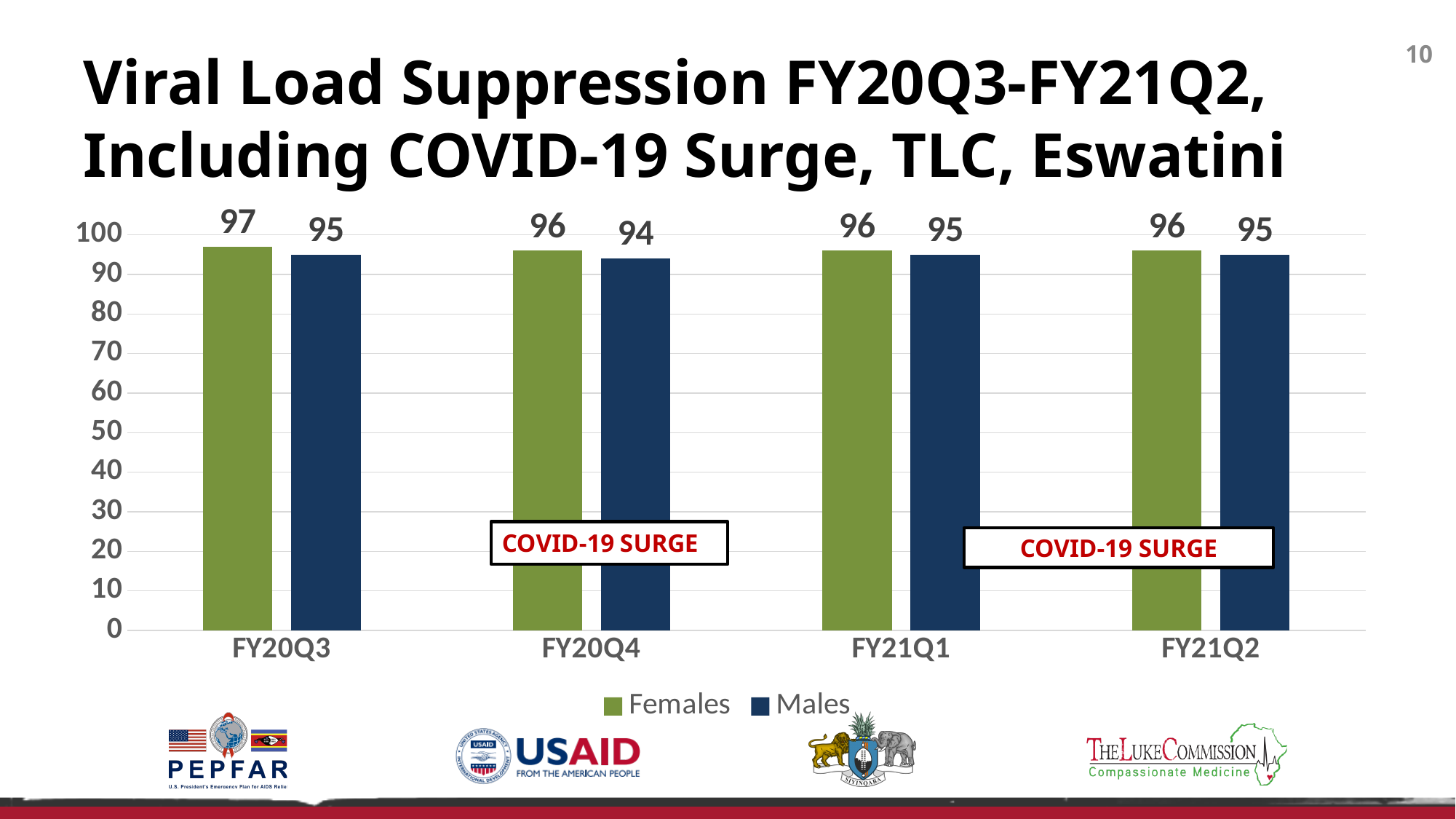
What is the value for Males in FY21Q2? 95 Which is larger in FY21Q1, the Females value or the Males value? Females What kind of chart is shown on the slide? Bar chart What is the difference between the Females and Males values in FY20Q3? 2 In which quarter is the Females value highest? FY20Q3 What is the value for Males in FY20Q4? 94 Does the Females value rise or fall from FY20Q3 to FY20Q4? Fall Which colour represents Males in the legend? Dark blue In which quarter is the Males value lowest? FY20Q4 What is the value for Females in FY20Q3? 97 How many quarters are shown on the x axis? 4 How many series does the legend list? 2